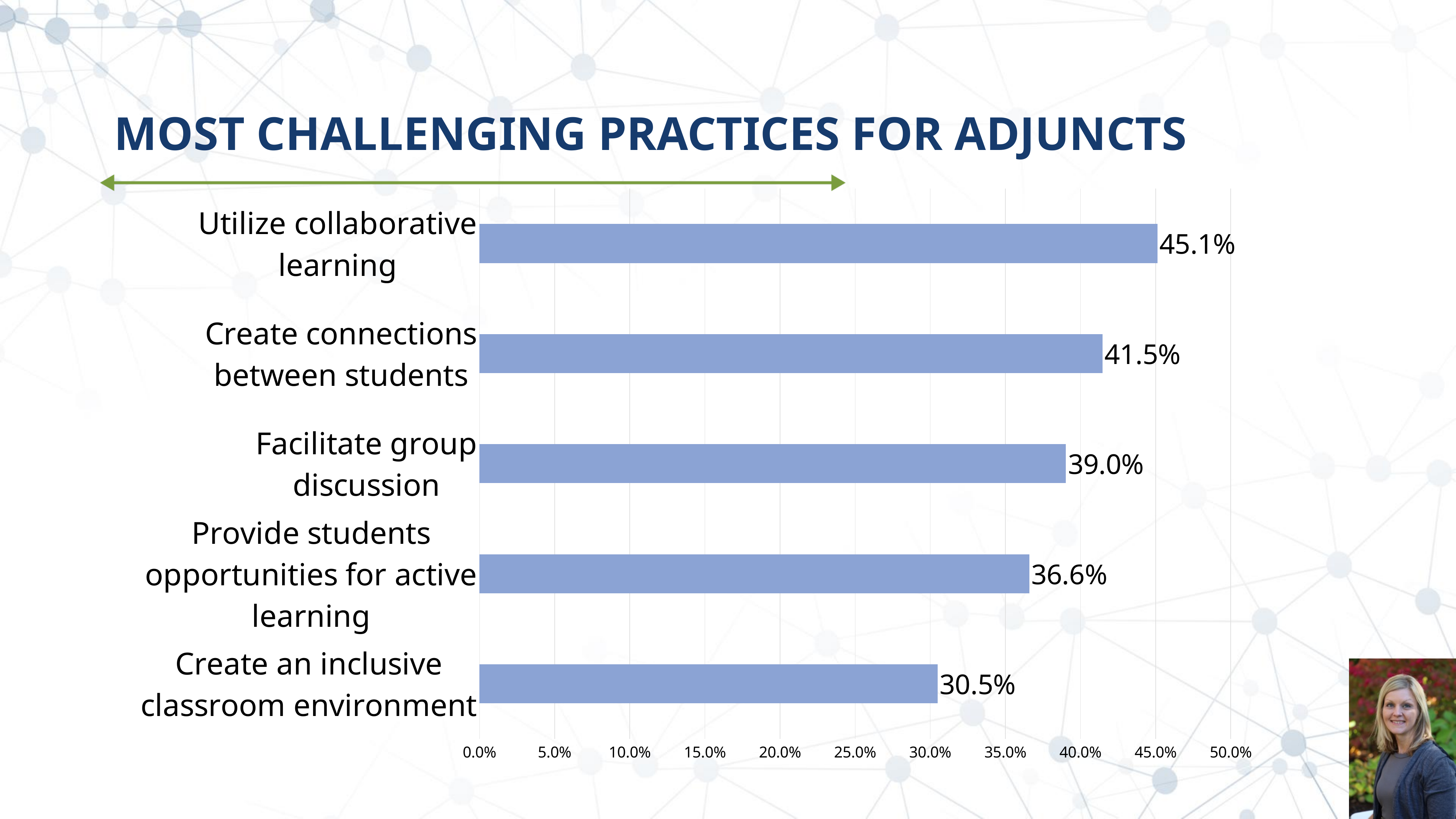
What is the difference between the values for "Utilize collaborative learning" and "Create connections between students"? 3.6% What is the difference between the values for "Facilitate group discussion" and "Create an inclusive classroom environment"? 8.5% Which practice has the highest value? Utilize collaborative learning What is the value for "Provide students opportunities for active learning"? 36.6% Is the value for "Create an inclusive classroom environment" greater or less than 35.0%? less What is the value for "Utilize collaborative learning"? 45.1% What is the value for "Facilitate group discussion"? 39.0% What is the value for "Create an inclusive classroom environment"? 30.5% Which is larger: the value for "Create connections between students" or "Provide students opportunities for active learning"? Create connections between students How many practices are shown in the chart? 5 Which practice has the lowest value? Create an inclusive classroom environment What kind of chart is shown on the slide? Bar chart